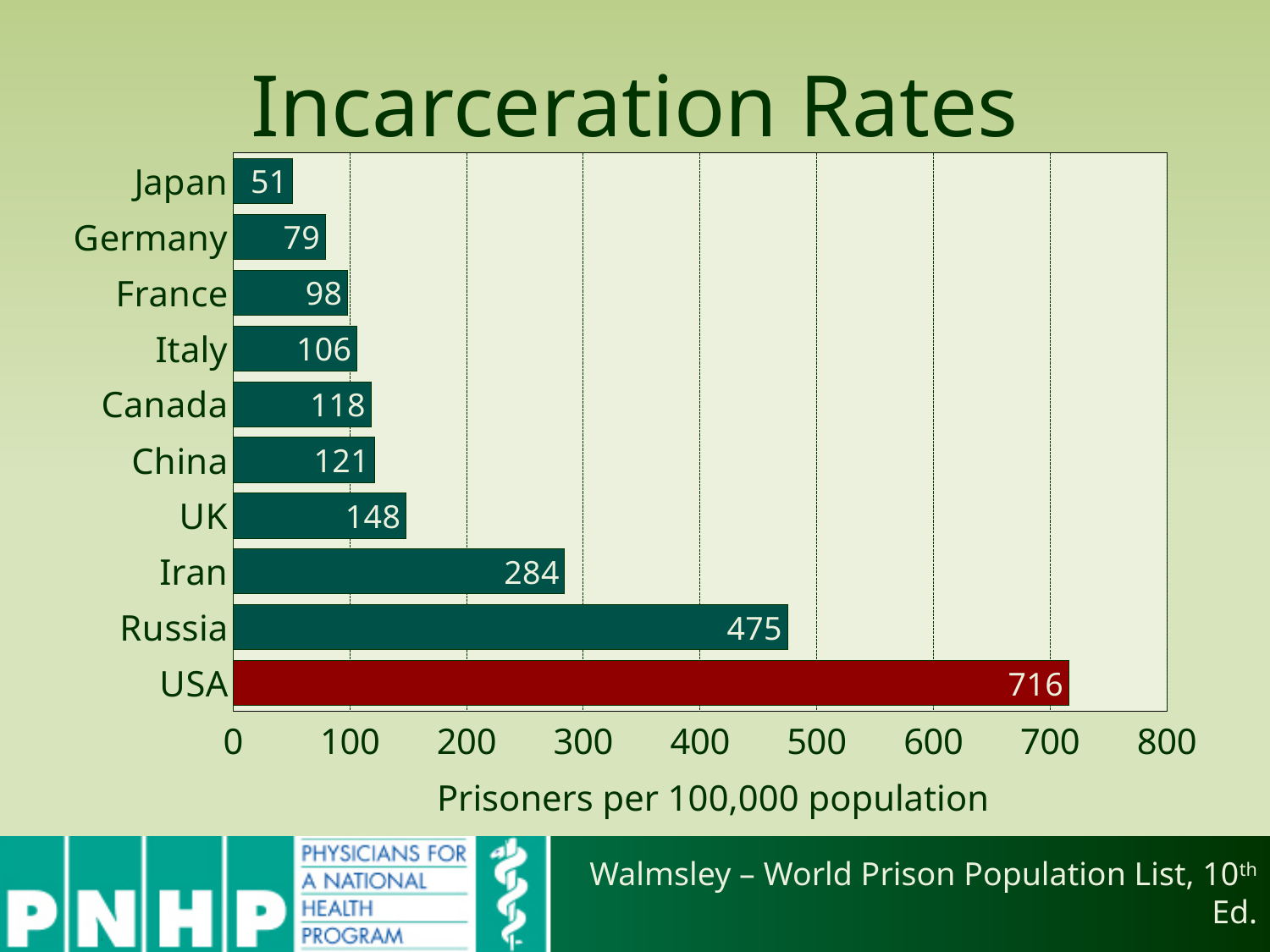
What is the difference between the incarceration rates of the UK and Canada? 30 What is the difference between the incarceration rates of the USA and Russia? 241 Which country has the lowest incarceration rate? Japan What is the incarceration rate for the USA? 716 Which country has the highest incarceration rate? USA Is the value for Russia greater or less than 400? greater What is the x-axis label of the chart? Prisoners per 100,000 population How many countries are shown in the chart? 10 What is the incarceration rate for Japan? 51 What is the incarceration rate for Russia? 475 What kind of chart is shown on the slide? Bar chart Which has a higher incarceration rate, Iran or the UK? Iran